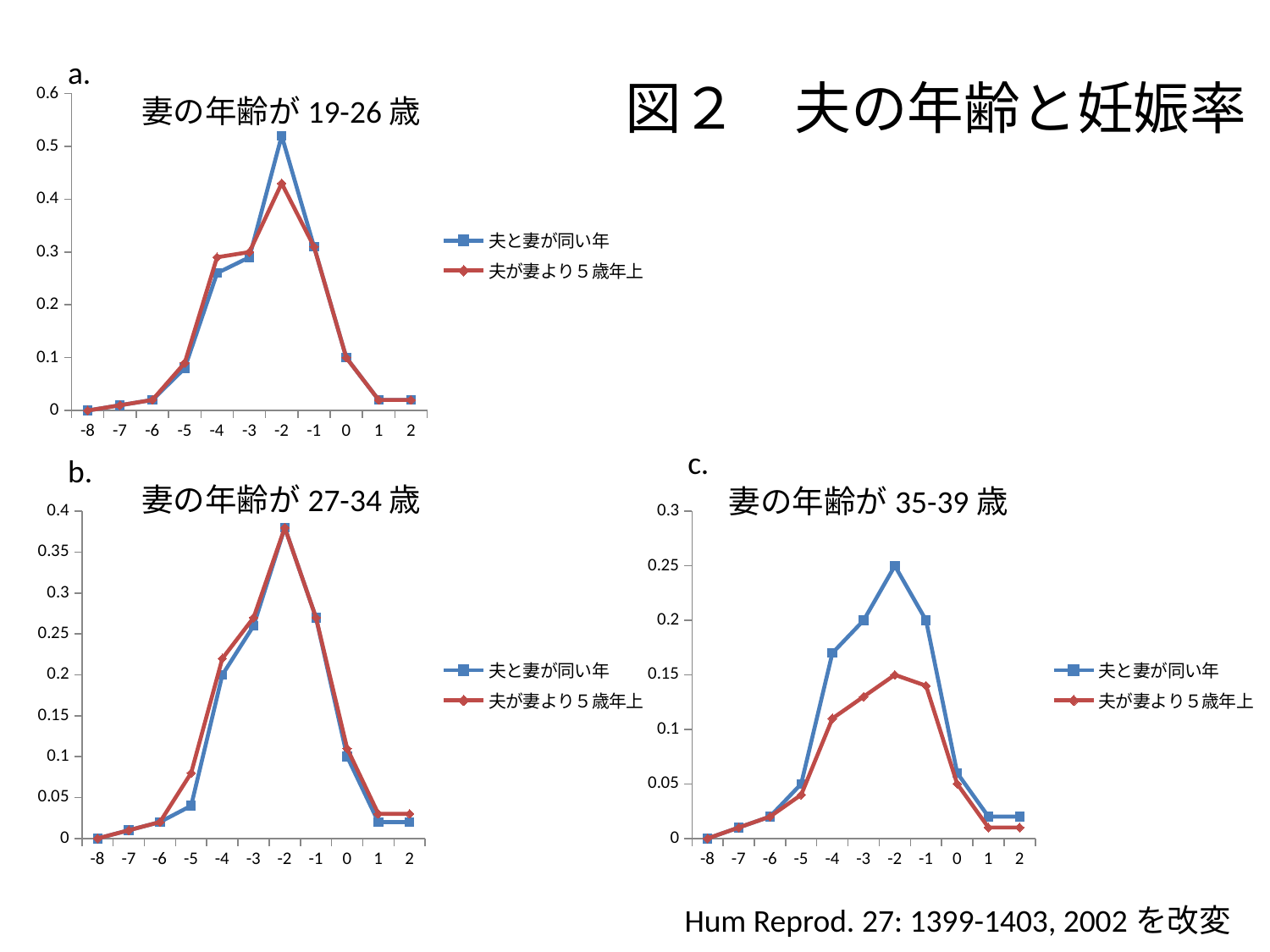
In chart a (妻の年齢が 19-26 歳), do the values of 夫と妻が同い年 rise or fall from x = -2 to x = 2? fall What is the title of the chart labelled c? 妻の年齢が 35-39 歳 In chart c (妻の年齢が 35-39 歳), at which x value does 夫と妻が同い年 reach its highest point? -2 How many points along the x axis does chart b (妻の年齢が 27-34 歳) plot for each series? 11 In chart a (妻の年齢が 19-26 歳), is the value of 夫が妻より５歳年上 at x = -2 greater or less than 0.5? less In chart a (妻の年齢が 19-26 歳), is the value of 夫と妻が同い年 at x = -2 greater or less than 0.5? greater In chart c (妻の年齢が 35-39 歳), what is the value of 夫が妻より５歳年上 at x = -2? 0.15 What kind of chart is chart a (妻の年齢が 19-26 歳)? line chart In chart b (妻の年齢が 27-34 歳), is the value of 夫と妻が同い年 at x = -2 greater or less than 0.35? greater In chart c (妻の年齢が 35-39 歳), which series is higher at x = -4, 夫と妻が同い年 or 夫が妻より５歳年上? 夫と妻が同い年 How many series does the legend of chart c (妻の年齢が 35-39 歳) list? 2 In chart c (妻の年齢が 35-39 歳), what is the value of 夫と妻が同い年 at x = -2? 0.25